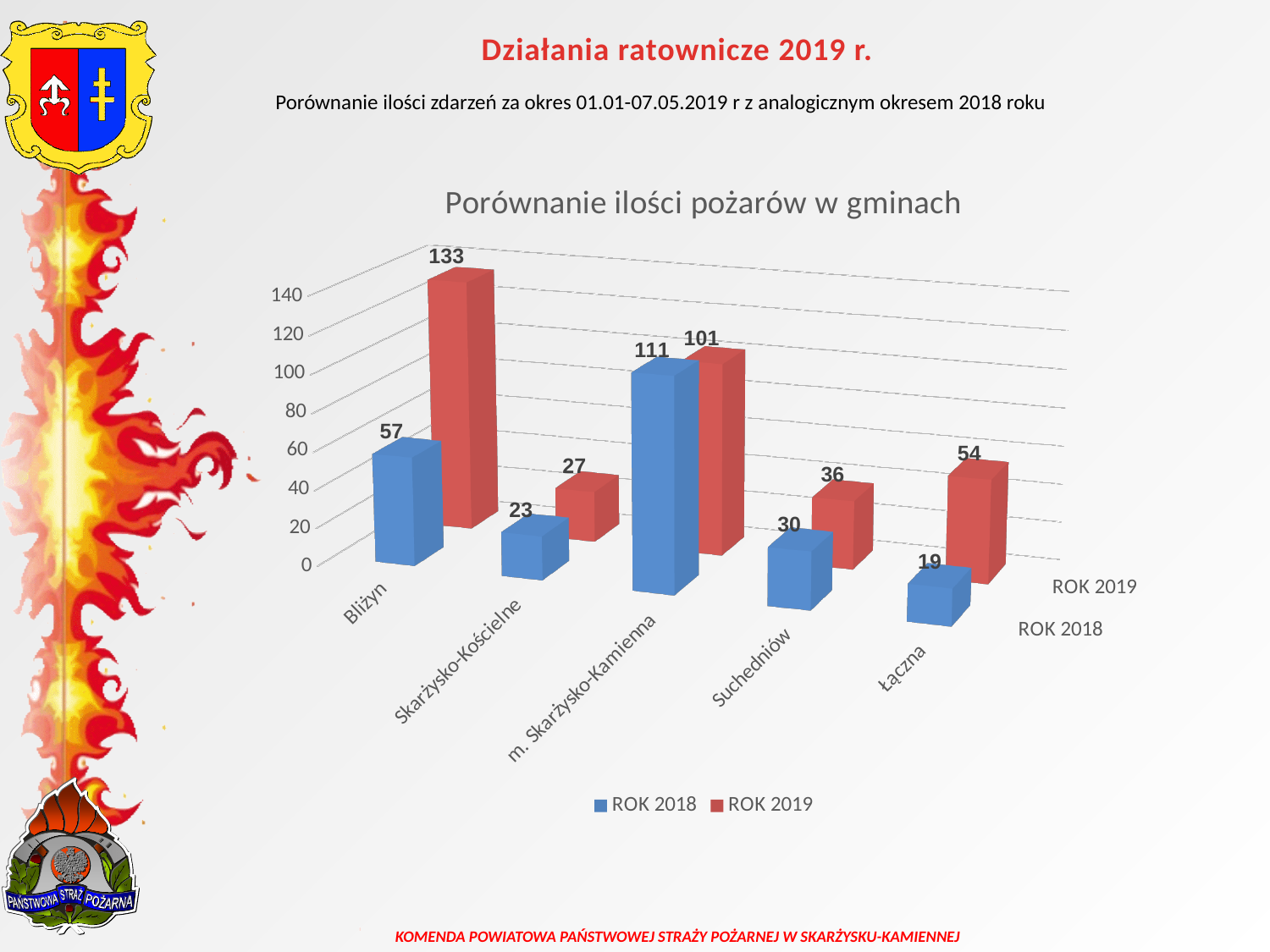
What is the difference between the ROK 2019 and ROK 2018 values for Bliżyn? 76 How many series does the legend list? 2 What is the value for Bliżyn in the ROK 2019 series? 133 How many categories (gminy) are shown on the x axis? 5 Which category has the lowest value in the ROK 2018 series? Łączna What is the value for Łączna in the ROK 2018 series? 19 Which is larger for m. Skarżysko-Kamienna: the ROK 2018 value or the ROK 2019 value? ROK 2018 What kind of chart is shown on the slide? Bar chart What is the value for m. Skarżysko-Kamienna in the ROK 2018 series? 111 What is the title of the chart? Porównanie ilości pożarów w gminach Which category has the highest value in the ROK 2019 series? Bliżyn What is the value for Suchedniów in the ROK 2019 series? 36